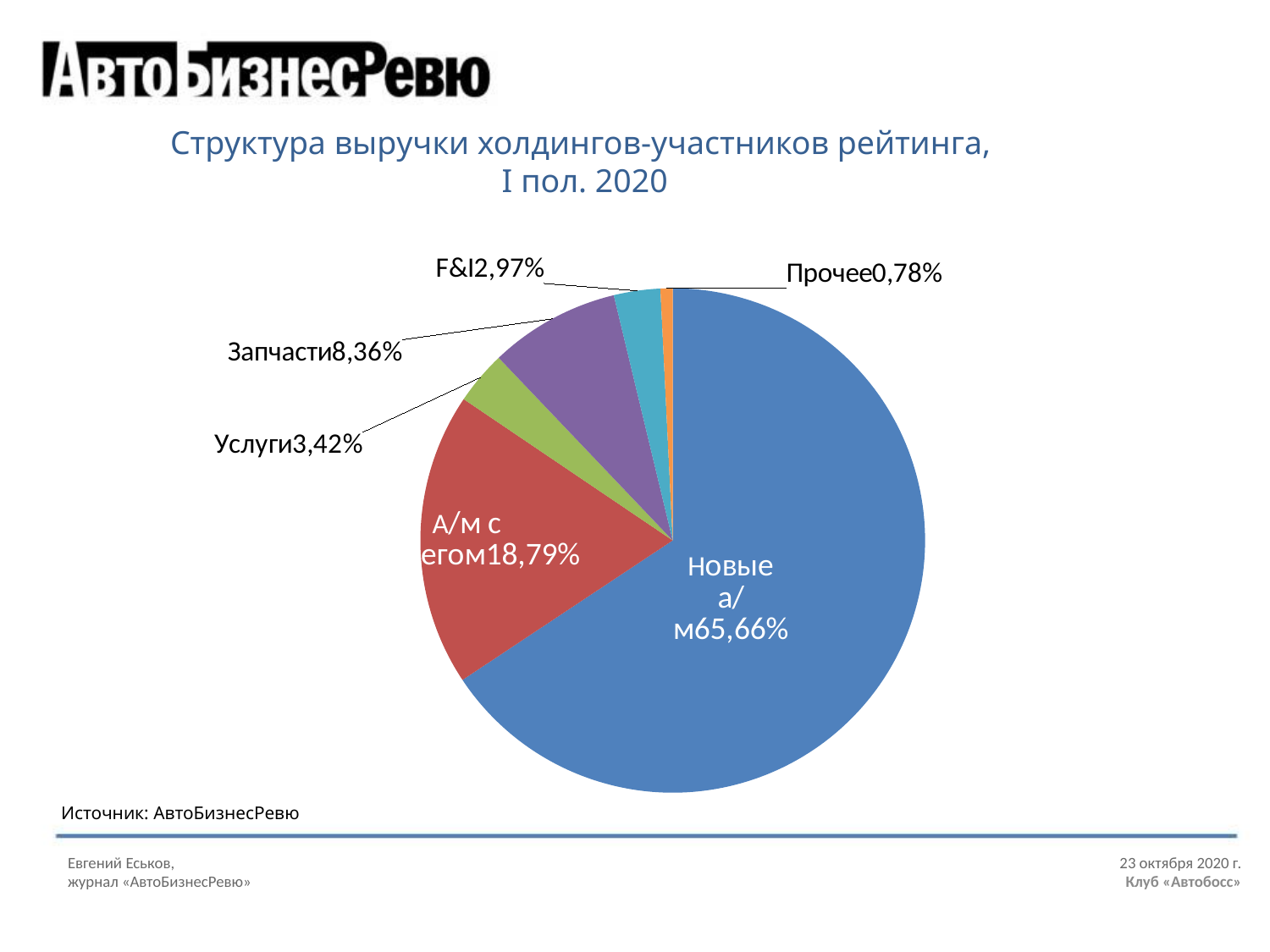
Which category has the smallest slice of the pie? Прочее How many slices does the pie chart have? 6 What kind of chart is shown on the slide? pie chart What is the value shown for F&I? 2,97% What is the value shown for Прочее? 0,78% What share of revenue does the Новые а/м slice represent? 65,66% What is the value shown for Запчасти? 8,36% Which is larger, Запчасти or Услуги? Запчасти What is the value shown for the red slice of the pie? 18,79% What is the difference between the values for Запчасти and Услуги? 4,94% Which category has the largest slice of the pie? Новые а/м What is the value shown for Услуги? 3,42%